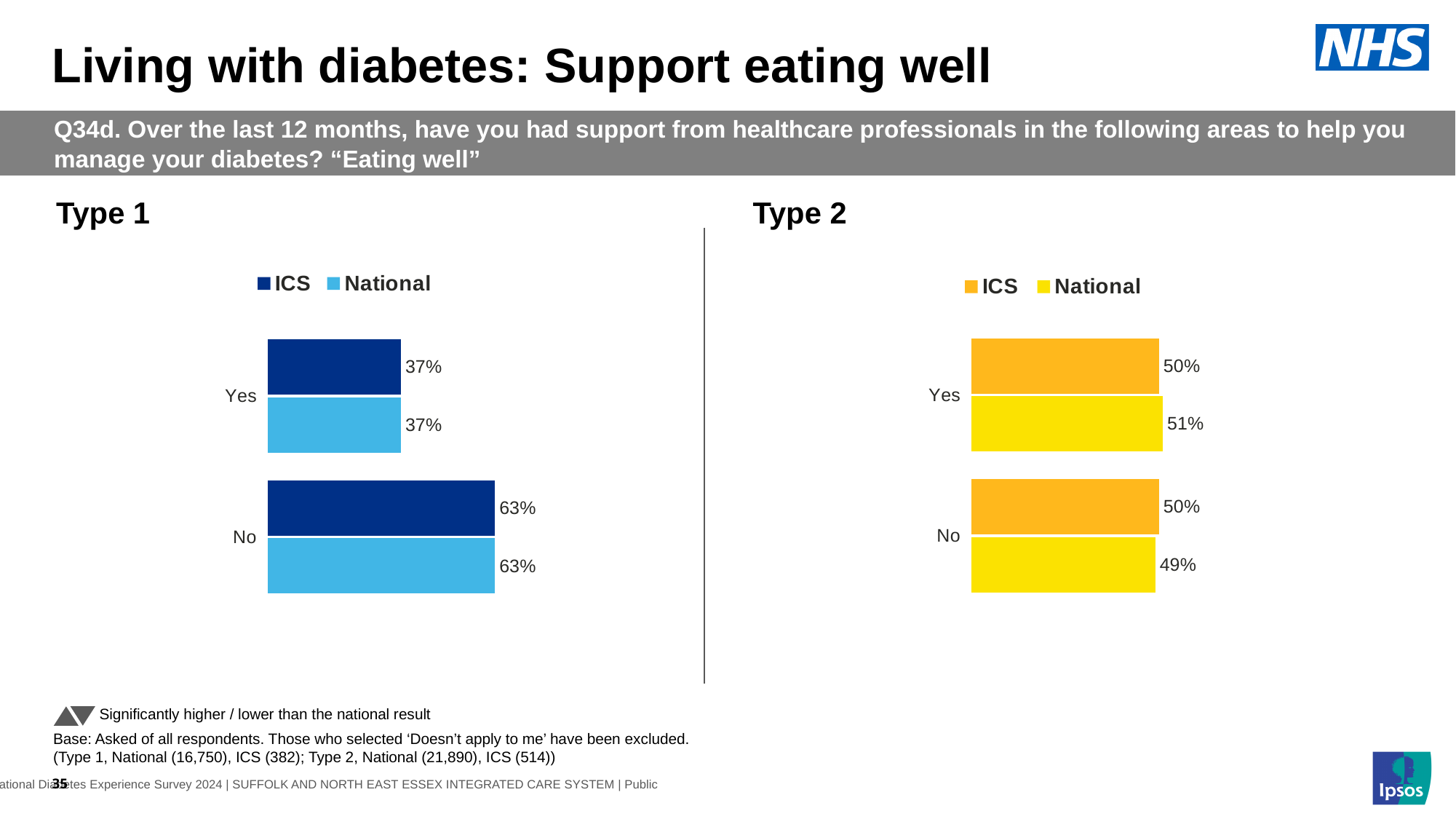
How many categories are shown in the Type 1 chart? 2 How many series does the legend of the Type 2 chart list? 2 What kind of chart is the Type 2 chart? Bar chart In the Type 2 chart, what is the difference between the National values for Yes and No? 2 percentage points In the Type 1 chart, what is the ICS value for Yes? 37% In the Type 2 chart, what is the National value for Yes? 51% In the Type 1 chart, which category has the higher ICS value, Yes or No? No In the Type 1 chart, what is the difference between the ICS values for No and Yes? 26 percentage points In the Type 2 chart, what is the National value for No? 49% In the Type 2 chart, what colour represents the National series? Yellow In the Type 2 chart, what is the ICS value for Yes? 50% In the Type 1 chart, what is the National value for No? 63%